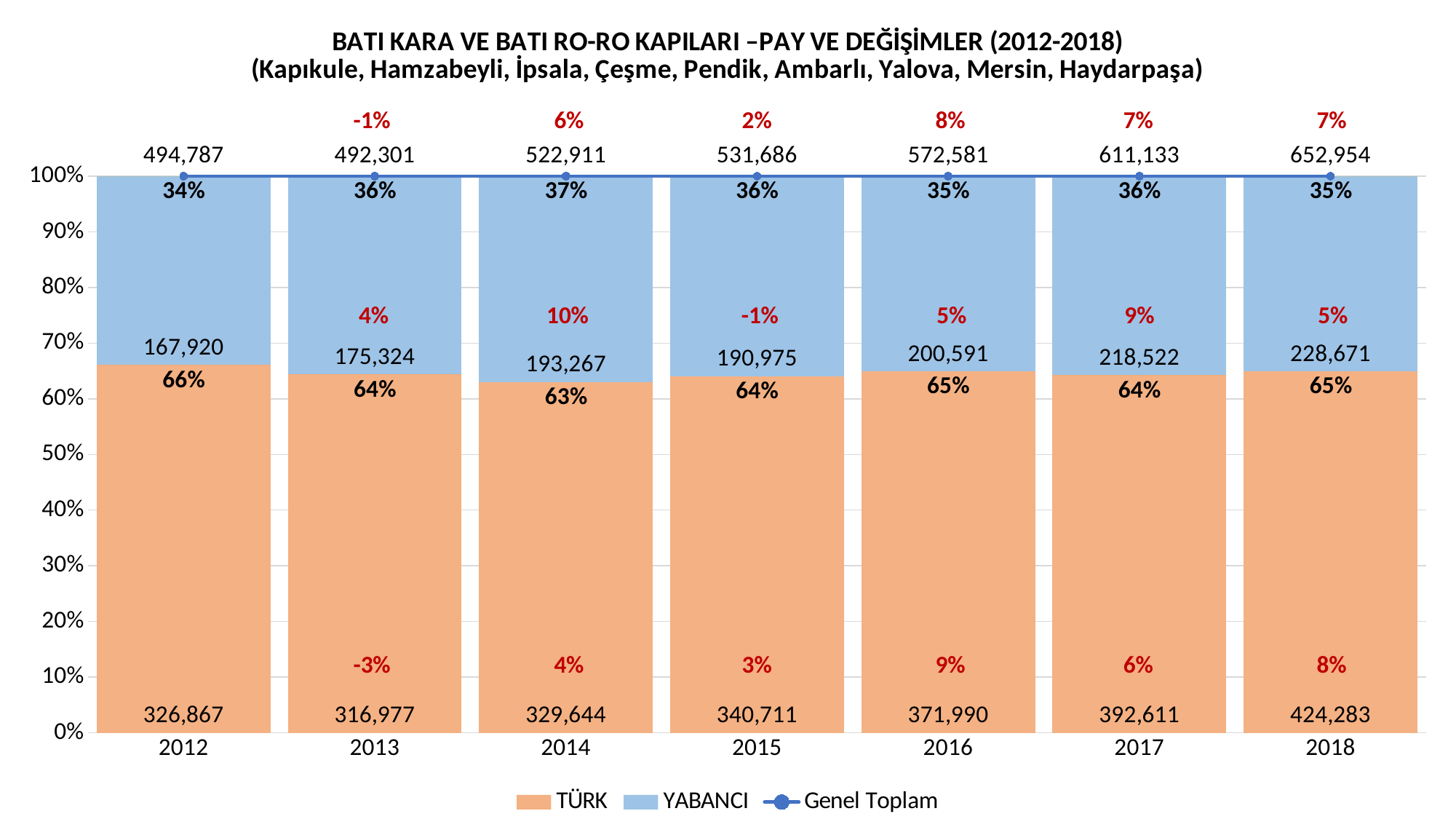
How many series does the legend list? 3 What kind of chart is this? Stacked bar chart with a line Does the Genel Toplam value rise or fall from 2013 to 2018? Rise What is the Genel Toplam value for 2016? 572,581 How many years are shown on the x axis? 7 What is the YABANCI value for 2014? 193,267 Which is larger, the YABANCI value for 2015 or for 2014? 2014 Which year has the lowest TÜRK value? 2013 What percentage share does TÜRK have in 2012? 66% What is the difference between the TÜRK values for 2018 and 2017? 31,672 Which year has the highest Genel Toplam value? 2018 What is the TÜRK value for 2018? 424,283